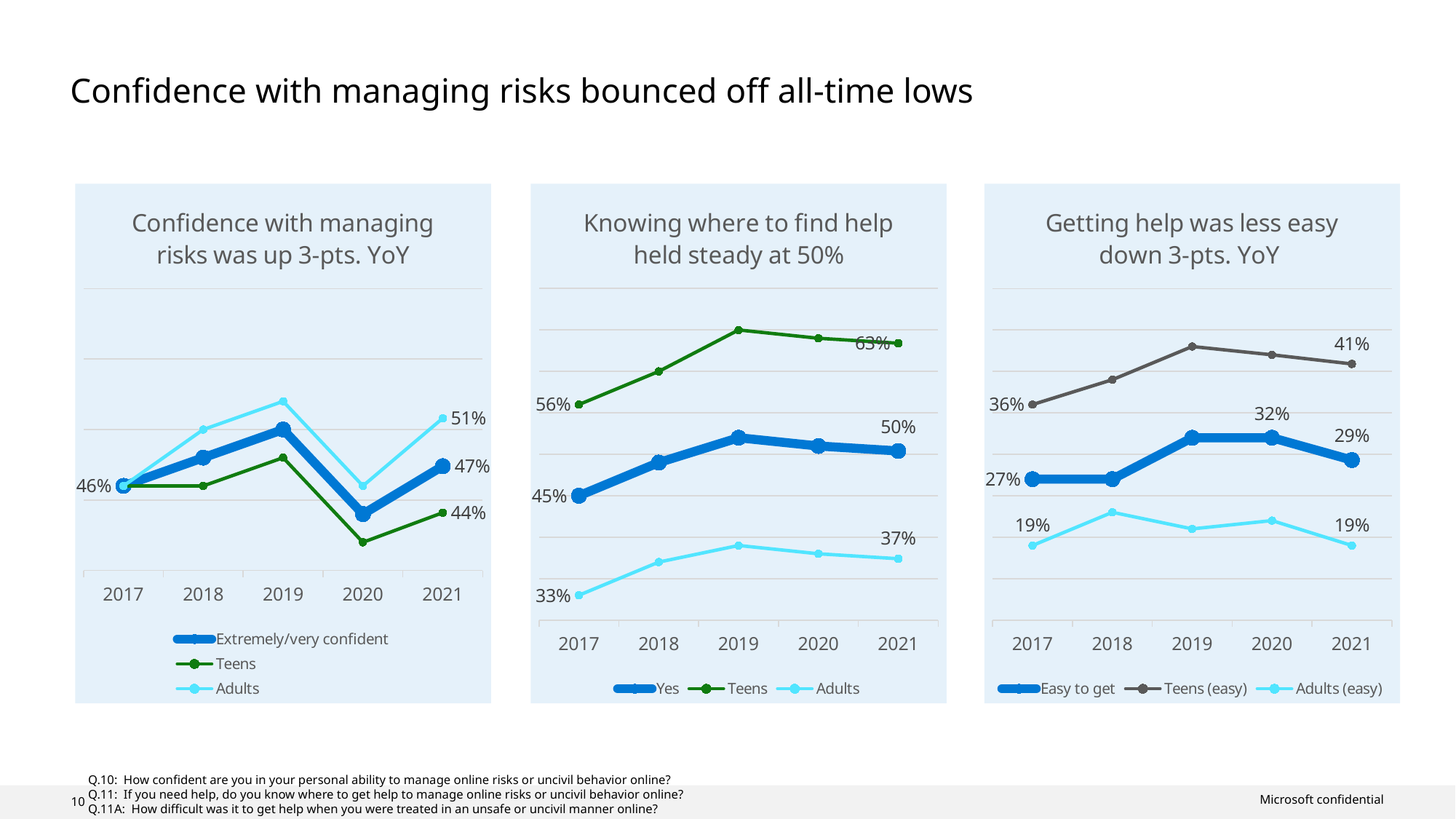
In the chart titled "Confidence with managing risks was up 3-pts. YoY", which series has the highest value in 2021? Adults How many years are shown on the x axis of the chart titled "Knowing where to find help held steady at 50%"? 5 In the chart titled "Getting help was less easy down 3-pts. YoY", what is the value for Easy to get in 2020? 32% In the chart titled "Confidence with managing risks was up 3-pts. YoY", what is the value for Adults in 2021? 51% In the chart titled "Knowing where to find help held steady at 50%", what is the value for Teens in 2021? 63% In the chart titled "Getting help was less easy down 3-pts. YoY", what is the difference between the Teens (easy) value in 2021 and in 2017? 5% In the chart titled "Knowing where to find help held steady at 50%", what is the difference between the Teens value and the Yes value in 2021? 13% In the chart titled "Confidence with managing risks was up 3-pts. YoY", which is larger in 2021: Extremely/very confident or Teens? Extremely/very confident In the chart titled "Getting help was less easy down 3-pts. YoY", which series has the lowest value in 2021? Adults (easy) In the chart titled "Knowing where to find help held steady at 50%", what is the value for Adults in 2017? 33% What kind of chart is the chart titled "Confidence with managing risks was up 3-pts. YoY"? Line chart How many series does the legend list in the chart titled "Getting help was less easy down 3-pts. YoY"? 3